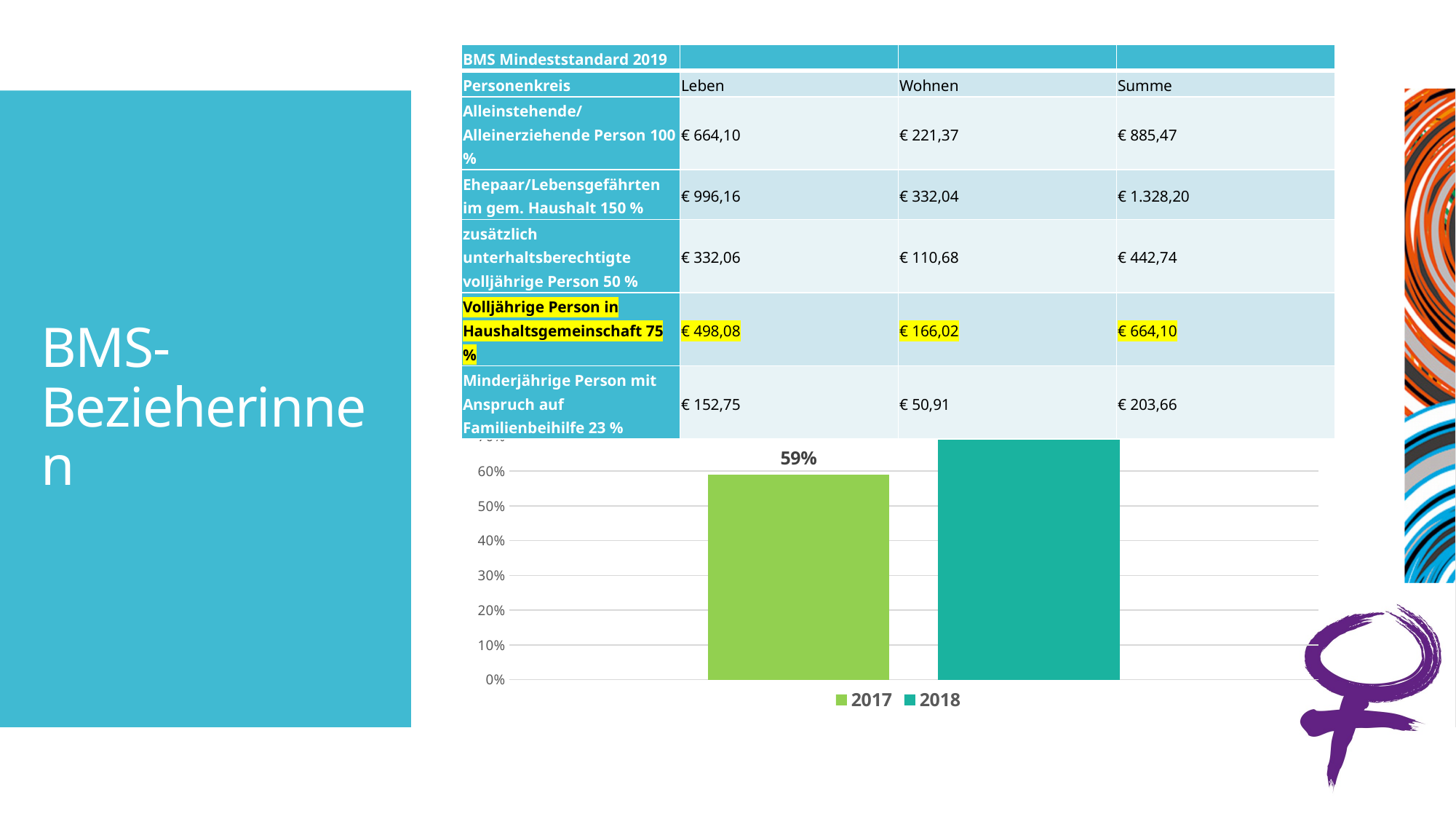
What are the two legend entries of the bar chart? 2017 and 2018 Is the value for 2017 in the bar chart greater or less than 50%? greater Which series has the lowest value in the bar chart? 2017 What colour is the 2017 bar in the bar chart? green What value is shown for 2017 in the bar chart? 59% Which year has the taller bar in the bar chart, 2017 or 2018? 2018 Do the values in the bar chart rise or fall from 2017 to 2018? rise How many series does the legend of the bar chart list? 2 Is the value for 2018 in the bar chart greater or less than 60%? greater Which series has the highest value in the bar chart? 2018 How many bars are plotted in the bar chart? 2 What kind of chart is shown at the bottom of the slide? bar chart